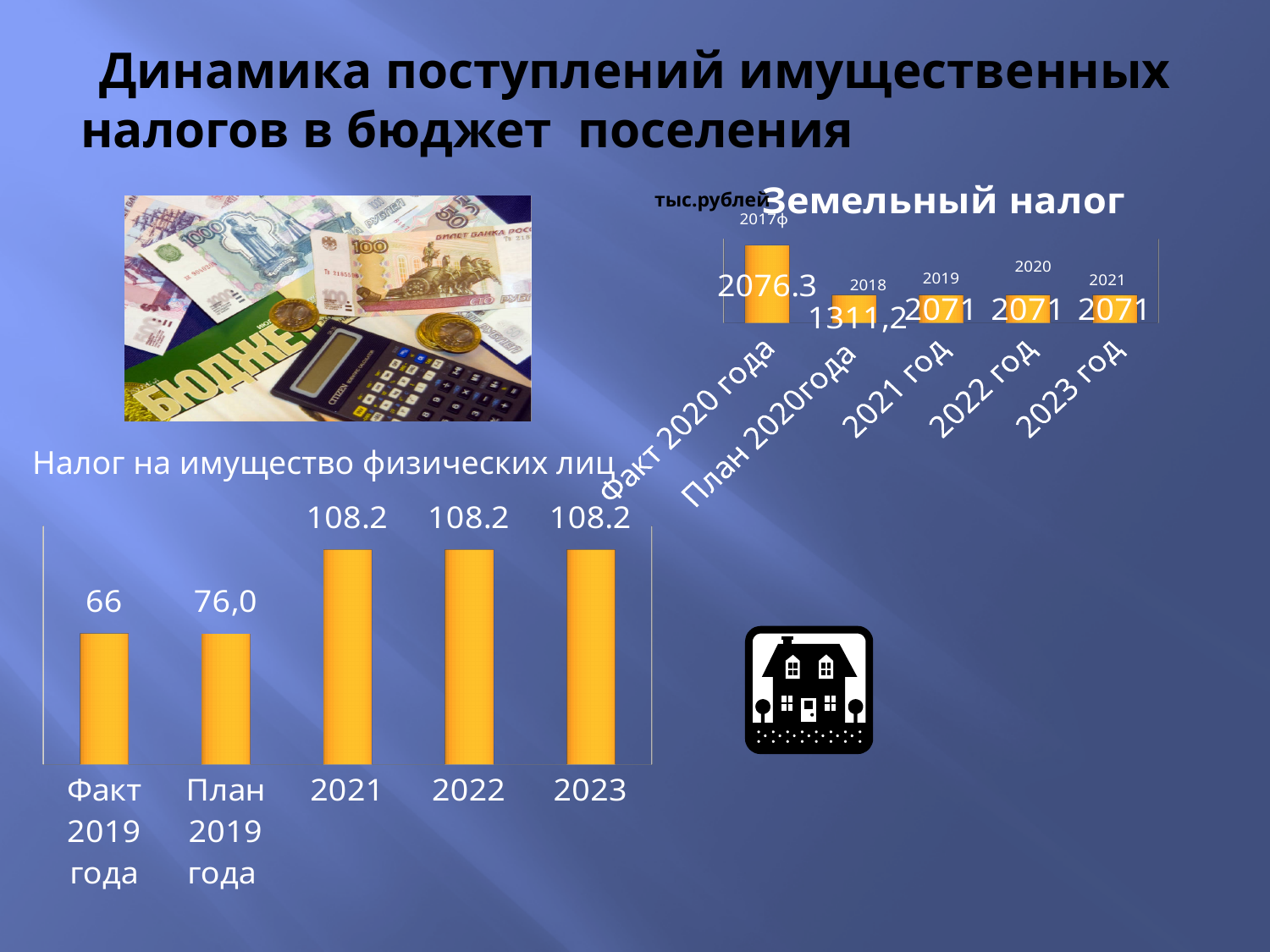
On the chart 'Земельный налог', what unit is indicated next to the title? тыс.рублей On the chart 'Земельный налог', what is the value for 'Факт 2020 года'? 2076.3 On the chart 'Налог на имущество физических лиц', which is larger: the value for 'План 2019 года' or the value for 2023? 2023 How many bars are shown on the chart 'Налог на имущество физических лиц'? 5 On the chart 'Земельный налог', what is the value for 'План 2020года'? 1311,2 On the chart 'Налог на имущество физических лиц', what is the value for 2022? 108.2 On the chart 'Налог на имущество физических лиц', what is the value for 'Факт 2019 года'? 66 On the chart 'Налог на имущество физических лиц', which category has the lowest value? Факт 2019 года On the chart 'Земельный налог', which category has the lowest value? План 2020года On the chart 'Налог на имущество физических лиц', what is the value for 'План 2019 года'? 76,0 What type of chart is 'Налог на имущество физических лиц'? bar chart On the chart 'Налог на имущество физических лиц', what is the difference between the value for 2021 and the value for 'Факт 2019 года'? 42.2